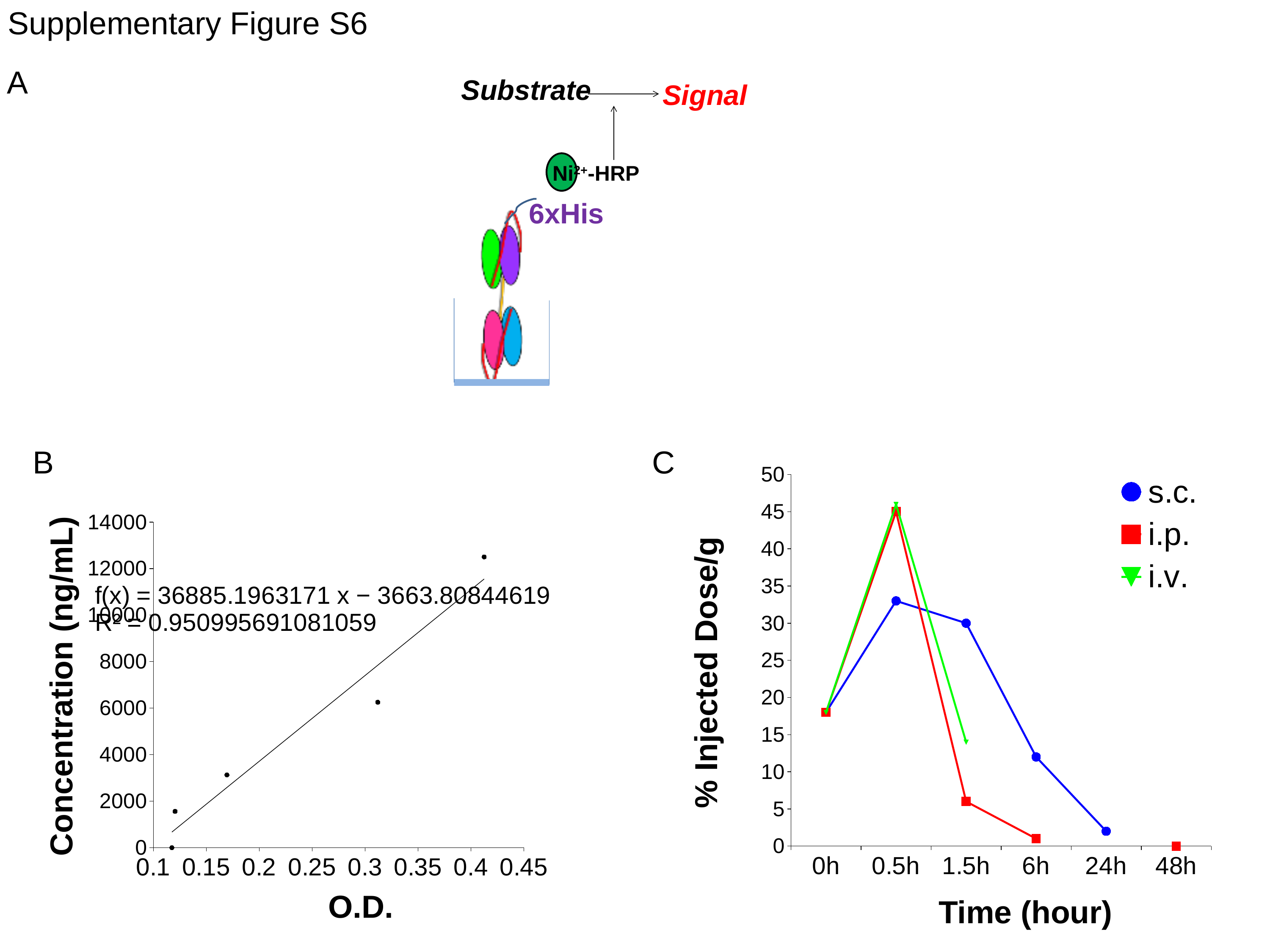
In chart C, at 1.5h, which series has the larger value: s.c. or i.p.? s.c. How many series does the legend of chart C list? 3 In chart C, which series is plotted with a blue circle marker? s.c. In chart B, do the concentration values rise or fall as O.D. increases? rise What kind of chart is chart C (% Injected Dose/g vs Time)? line chart In chart C, is the value for s.c. at 6h greater or less than 15? less How many time points are labelled on the x axis of chart C? 6 In chart C, is the value for i.p. at 1.5h greater or less than 10? less In chart C, is the value for i.v. at 0.5h greater or less than 40? greater In chart B (Concentration vs O.D.), how many data points are plotted? 5 In chart C, at which time point does the s.c. series reach its highest value? 0.5h In chart C, at 0.5h, which series has the larger value: i.p. or s.c.? i.p.